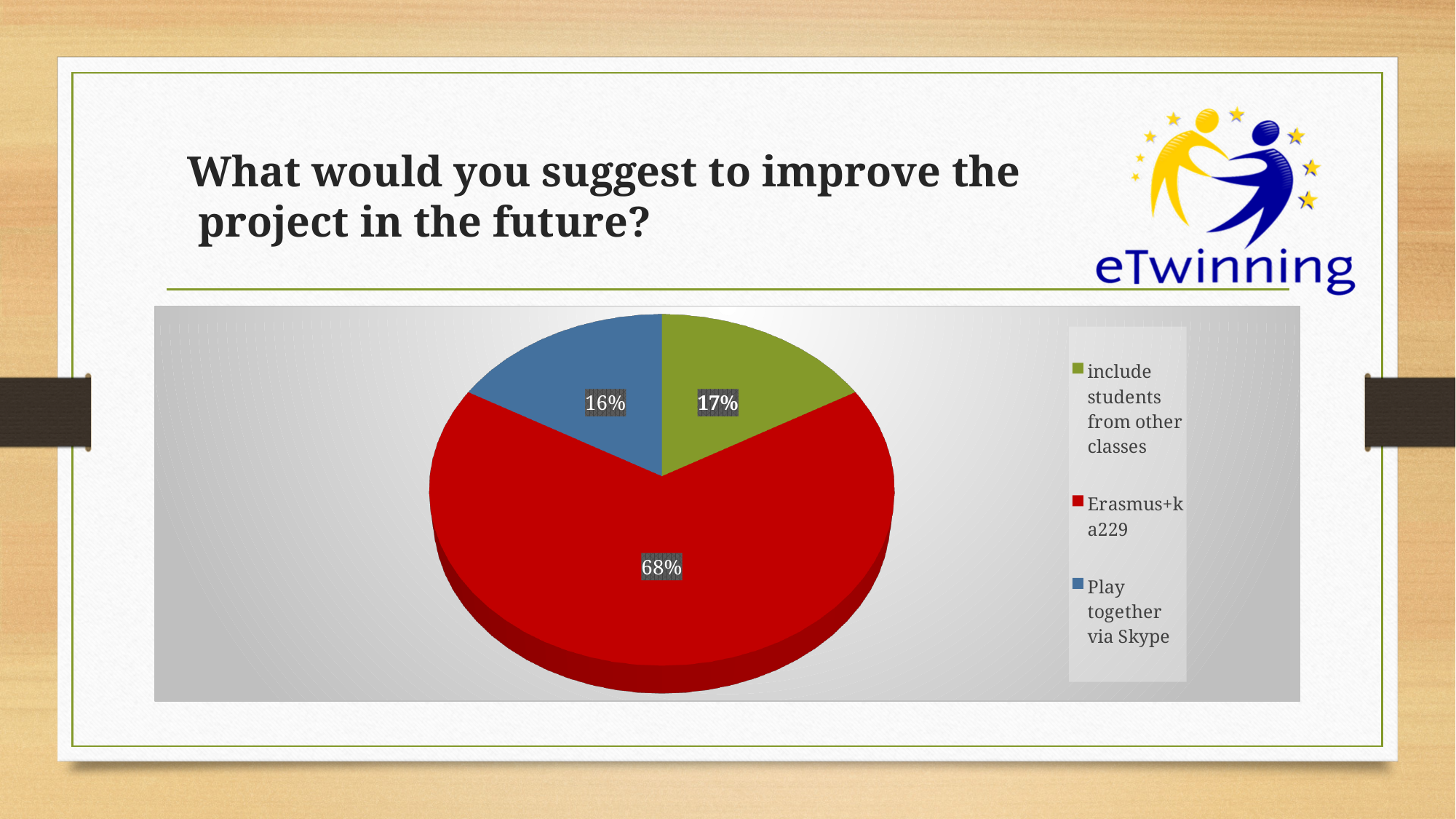
Which category has the smallest slice of the pie? Play together via Skype What is the title of the slide containing the pie chart? What would you suggest to improve the project in the future? What is the difference in percentage points between the "Erasmus+ka229" slice and the "include students from other classes" slice? 51 What share of the pie does "include students from other classes" have? 17% Which category has the largest slice of the pie? Erasmus+ka229 What kind of chart is shown on the slide? pie chart How many slices does the pie chart have? 3 What share of the pie does "Play together via Skype" have? 16% What is the difference in percentage points between the "include students from other classes" slice and the "Play together via Skype" slice? 1 What share of the pie does "Erasmus+ka229" have? 68% Which is larger, the "Erasmus+ka229" slice or the "Play together via Skype" slice? Erasmus+ka229 What colour is the "Erasmus+ka229" slice? red